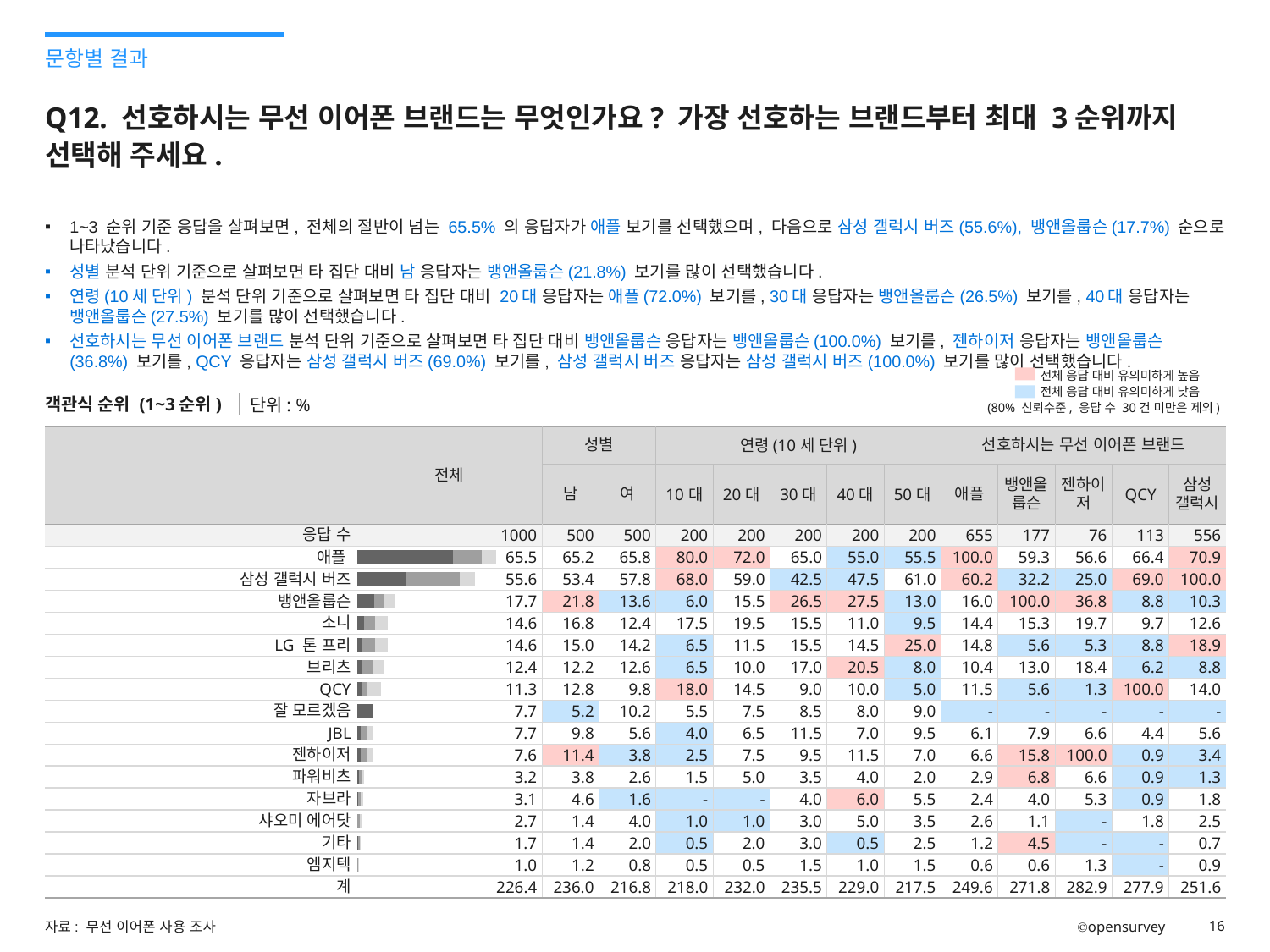
In the bar chart of overall (전체) results, do the values rise or fall going from the top row to the bottom row? fall In the bar chart of overall (전체) results, what is the value for 뱅앤올룹슨? 17.7 In the bar chart of overall (전체) results, which brand has the highest value? 애플 What kind of chart is shown in the 전체 column of the table? bar chart In the bar chart of overall (전체) results, what is the value for 애플? 65.5 In the bar chart of overall (전체) results, what is the value for 젠하이저? 7.6 In the bar chart of overall (전체) results, which brand has the lowest value? 엠지텍 How many brand categories (excluding 응답 수 and 계) are shown in the bar chart of overall (전체) results? 15 In the bar chart of overall (전체) results, what is the difference between 뱅앤올룹슨 and 소니? 3.1 In the bar chart of overall (전체) results, what is the difference between 애플 and 삼성 갤럭시 버즈? 9.9 In the bar chart of overall (전체) results, which is larger, 브리츠 or QCY? 브리츠 What unit is stated for the values in the chart? %